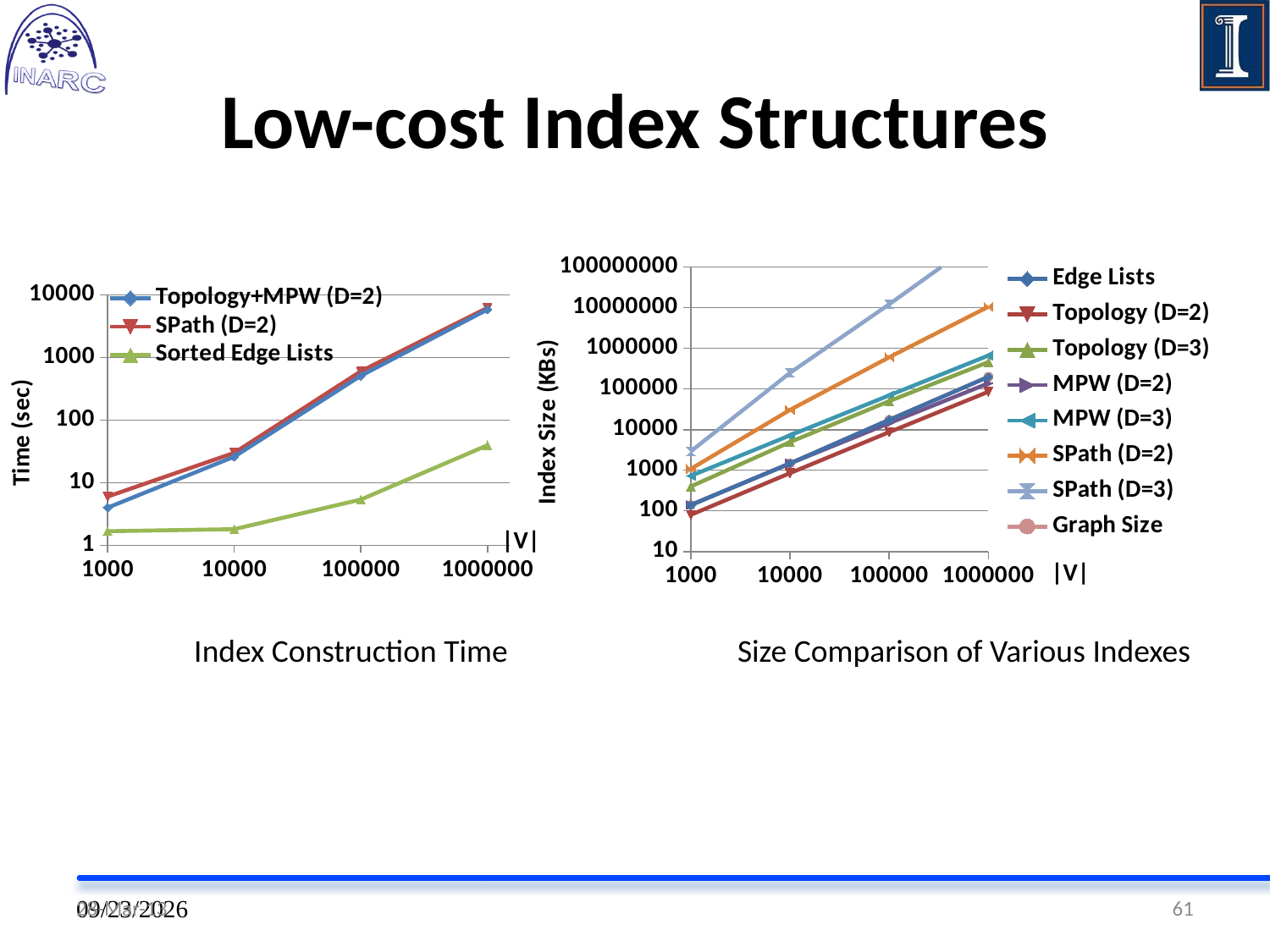
In the Index Construction Time chart, is the value for Sorted Edge Lists at |V| = 1000000 greater or less than 100? less In the Index Construction Time chart, do the values rise or fall as |V| increases? rise How many series does the legend of the Size Comparison of Various Indexes chart list? 8 How many |V| values are plotted along the x axis of the Index Construction Time chart? 4 In the Size Comparison of Various Indexes chart, which series has the smallest index size at |V| = 1000? Topology (D=2) In the Index Construction Time chart, is the value for Topology+MPW (D=2) at |V| = 1000000 greater or less than 1000? greater How many series does the legend of the Index Construction Time chart list? 3 In the Size Comparison of Various Indexes chart, which is larger at |V| = 10000: SPath (D=2) or Edge Lists? SPath (D=2) In the Size Comparison of Various Indexes chart, which series has the largest index size at |V| = 1000000? SPath (D=3) What kind of chart is the Index Construction Time chart? line chart In the Size Comparison of Various Indexes chart, is the value for SPath (D=2) at |V| = 1000000 greater or less than 1000000? greater In the Index Construction Time chart, which series has the lowest construction time across all |V| values? Sorted Edge Lists